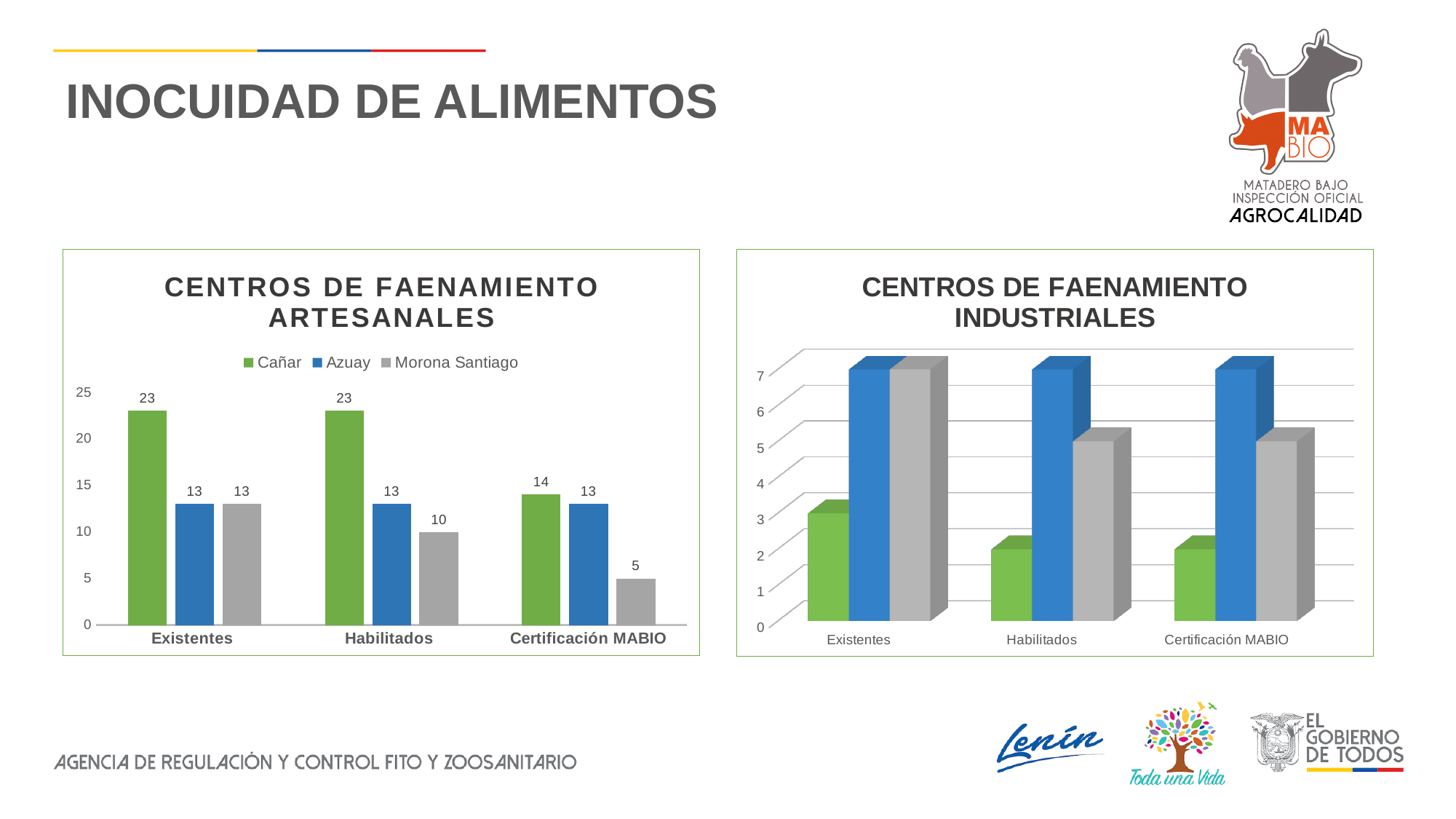
In the CENTROS DE FAENAMIENTO INDUSTRIALES chart, is the value of the blue bar for Existentes greater or less than 5? greater What kind of chart is the CENTROS DE FAENAMIENTO INDUSTRIALES chart? Bar chart In the CENTROS DE FAENAMIENTO ARTESANALES chart, which series has the lowest value in the Certificación MABIO category? Morona Santiago In the CENTROS DE FAENAMIENTO ARTESANALES chart, what is the value for Cañar in the Existentes category? 23 How many series does the legend of the CENTROS DE FAENAMIENTO ARTESANALES chart list? 3 How many categories are shown on the x axis of the CENTROS DE FAENAMIENTO INDUSTRIALES chart? 3 In the CENTROS DE FAENAMIENTO ARTESANALES chart, which is larger: Cañar for Existentes or Cañar for Certificación MABIO? Cañar for Existentes In the CENTROS DE FAENAMIENTO ARTESANALES chart, what is the value for Cañar in the Certificación MABIO category? 14 In the CENTROS DE FAENAMIENTO ARTESANALES chart, what is the value for Morona Santiago in the Certificación MABIO category? 5 In the CENTROS DE FAENAMIENTO ARTESANALES chart, what is the value for Azuay in the Habilitados category? 13 In the CENTROS DE FAENAMIENTO ARTESANALES chart, does the Morona Santiago value rise or fall from Existentes to Certificación MABIO? Fall In the CENTROS DE FAENAMIENTO ARTESANALES chart, what is the difference between the Cañar and Morona Santiago values for Habilitados? 13